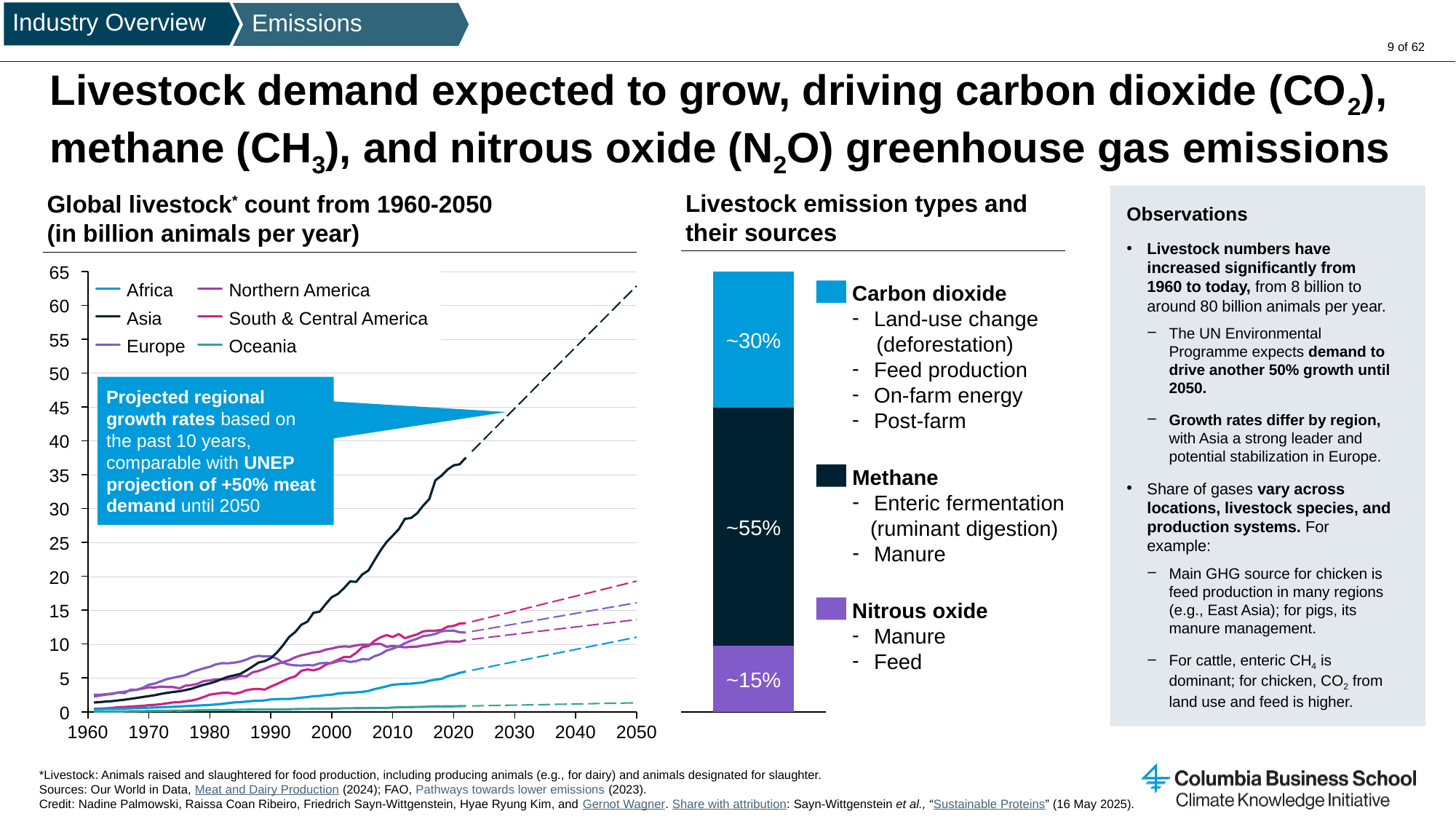
On the 'Global livestock count from 1960-2050' chart, which is larger in 2050: the projected value for Asia or for Europe? Asia On the 'Livestock emission types and their sources' chart, what share is shown for methane? ~55% On the 'Global livestock count from 1960-2050' chart, does the Asia line rise or fall from 1960 to 2050? rises What kind of chart is the 'Global livestock count from 1960-2050' chart? line chart On the 'Global livestock count from 1960-2050' chart, is the projected value for Africa in 2050 greater or less than 15? less On the 'Global livestock count from 1960-2050' chart, which region has the lowest count across the whole period? Oceania On the 'Global livestock count from 1960-2050' chart, how many regions does the legend list? 6 On the 'Livestock emission types and their sources' chart, which emission type has the smallest share? Nitrous oxide On the 'Livestock emission types and their sources' chart, how many emission types make up the stacked bar? 3 On the 'Global livestock count from 1960-2050' chart, which region has the highest projected count in 2050? Asia On the 'Global livestock count from 1960-2050' chart, is the projected value for Asia in 2050 greater or less than 60? greater On the 'Livestock emission types and their sources' chart, what colour is the carbon dioxide segment? blue